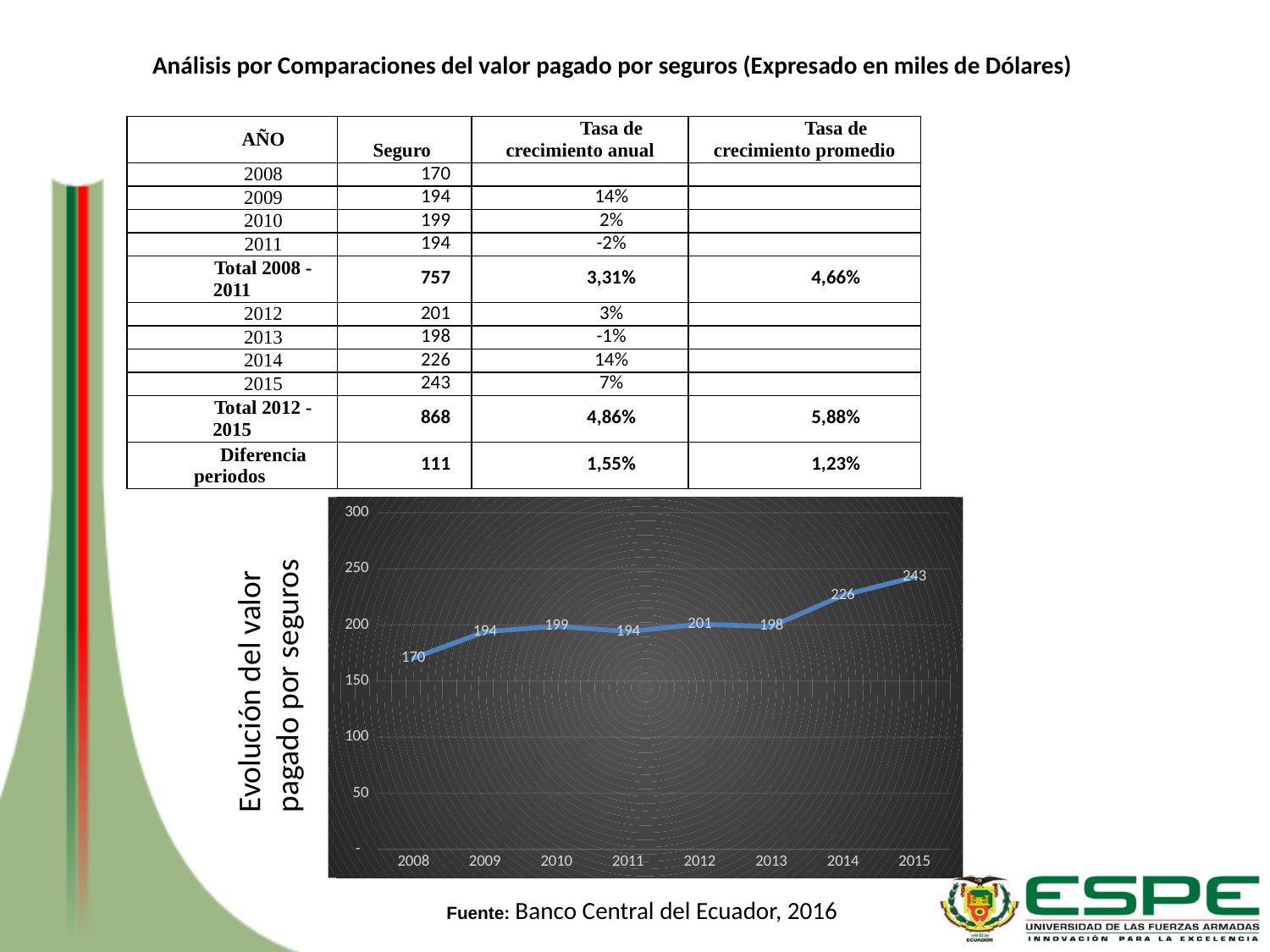
What is the title of the chart? Evolución del valor pagado por seguros What is the difference between the values for 2015 and 2008? 73 Which year has the lowest value on the chart? 2008 What is the difference between the values for 2014 and 2013? 28 What is the value plotted for 2008? 170 Which is larger, the value for 2010 or the value for 2013? 2010 What type of chart is shown on the slide? line chart What is the value plotted for 2014? 226 What is the value plotted for 2012? 201 Which year has the highest value on the chart? 2015 How many years are plotted on the x axis of the chart? 8 Is the value for 2015 greater or less than 200? greater